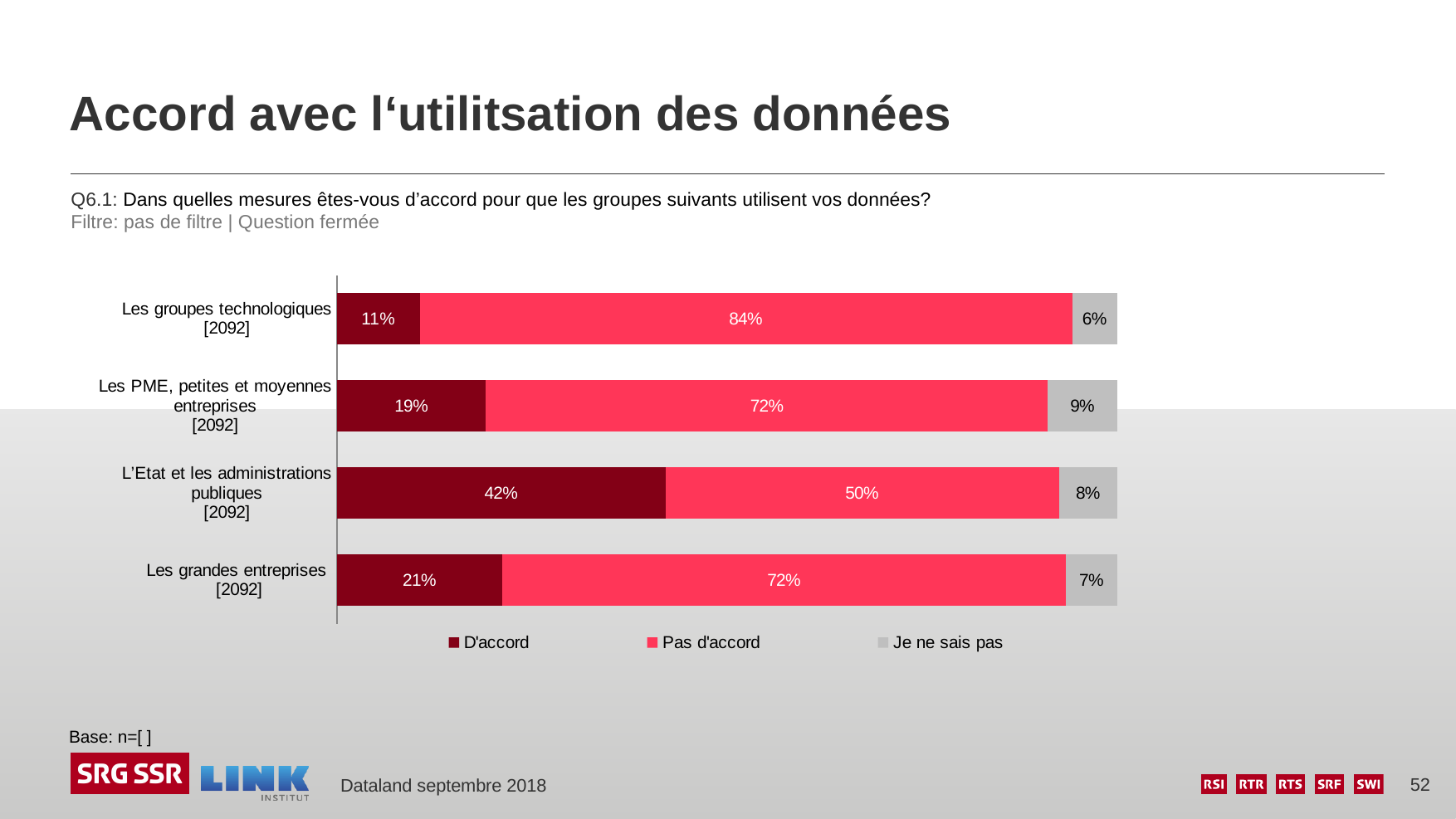
Which group has the highest 'D'accord' share? L'Etat et les administrations publiques Which group has the highest 'Pas d'accord' share? Les groupes technologiques How many series does the legend list? 3 What is the difference between the 'D'accord' values for L'Etat et les administrations publiques and Les grandes entreprises? 21 percentage points What percentage of respondents are 'D'accord' with Les groupes technologiques using their data? 11% What type of chart is shown on the slide? Stacked bar chart What is the total of the three segments for Les grandes entreprises? 100% Which is larger: the 'D'accord' value for Les PME or for Les grandes entreprises? Les grandes entreprises How many groups (categories) are shown in the chart? 4 Which group has the lowest 'D'accord' share? Les groupes technologiques What is the 'Pas d'accord' value for L'Etat et les administrations publiques? 50% What is the 'Je ne sais pas' value for Les PME, petites et moyennes entreprises? 9%